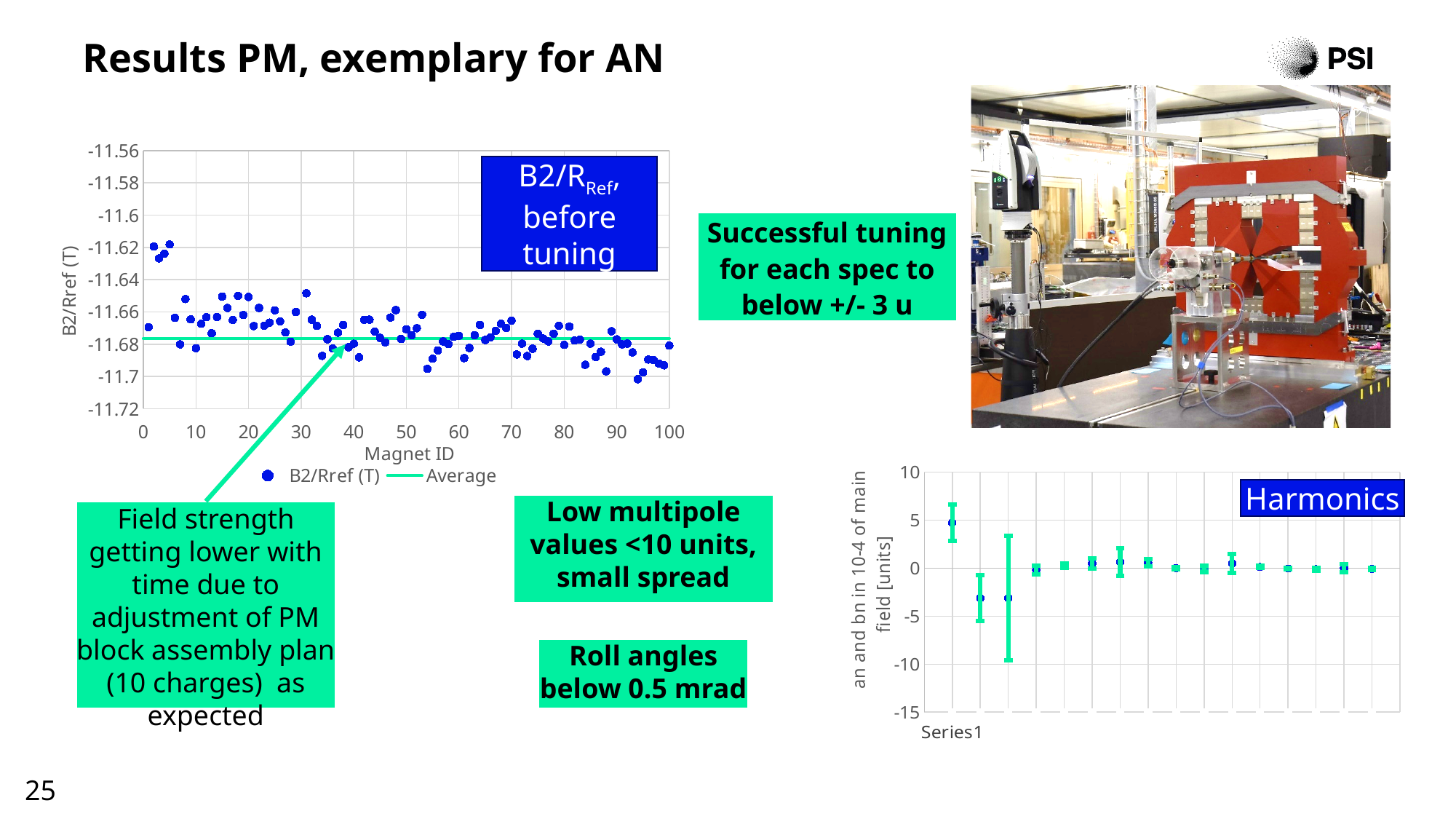
What are the two legend entries of the left chart (B2/RRef, before tuning)? B2/Rref (T) and Average What kind of chart is the 'Harmonics' chart at the bottom right? scatter chart What is the x-axis label of the left chart (B2/RRef, before tuning)? Magnet ID In the left chart (B2/RRef, before tuning), is the Average line greater or less than -11.7? greater How many series does the legend of the left chart (B2/RRef, before tuning) list? 2 What kind of chart is the 'B2/RRef, before tuning' chart on the left? scatter chart In the left chart (B2/RRef, before tuning), is the Average line greater or less than -11.66? less In the Harmonics chart, is the value of the first (leftmost) point greater or less than 0? greater In the Harmonics chart, what is the lowest value shown on the y axis? -15 In the left chart (B2/RRef, before tuning), do the B2/Rref values generally rise or fall as Magnet ID increases? fall